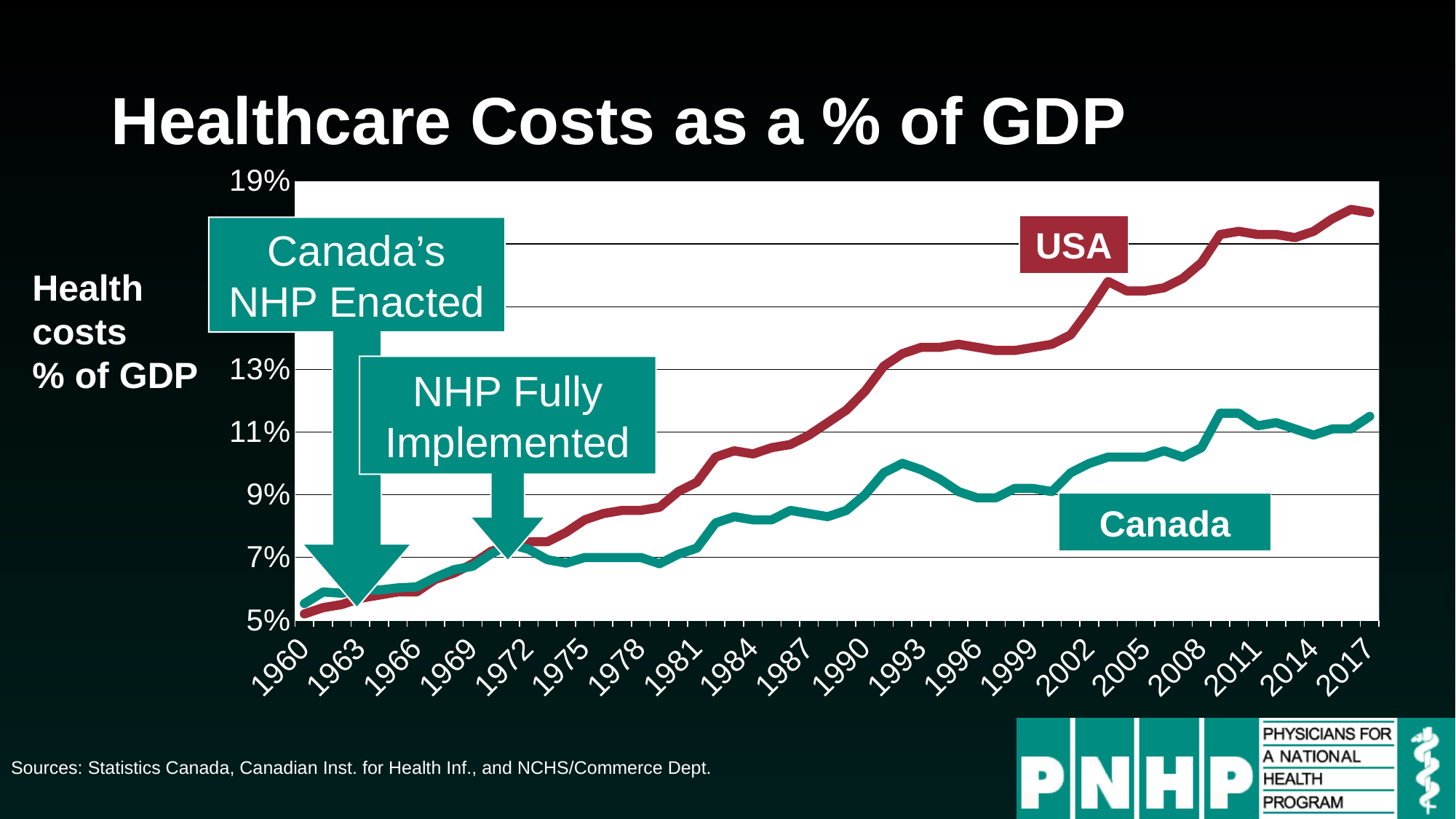
Is the value for USA in 2017 greater or less than 17%? greater What label is shown on the vertical axis of the chart? Health costs % of GDP Is the value for Canada in 1981 greater or less than 9%? less What kind of chart is shown on the slide? line chart Is the value for Canada in 2017 greater or less than 13%? less Does the USA series generally rise or fall from 1960 to 2017? rise Which series is higher in 2017, USA or Canada? USA Which series reaches the highest value on the chart? USA What is the title of the chart? Healthcare Costs as a % of GDP How many series are plotted on the chart? 2